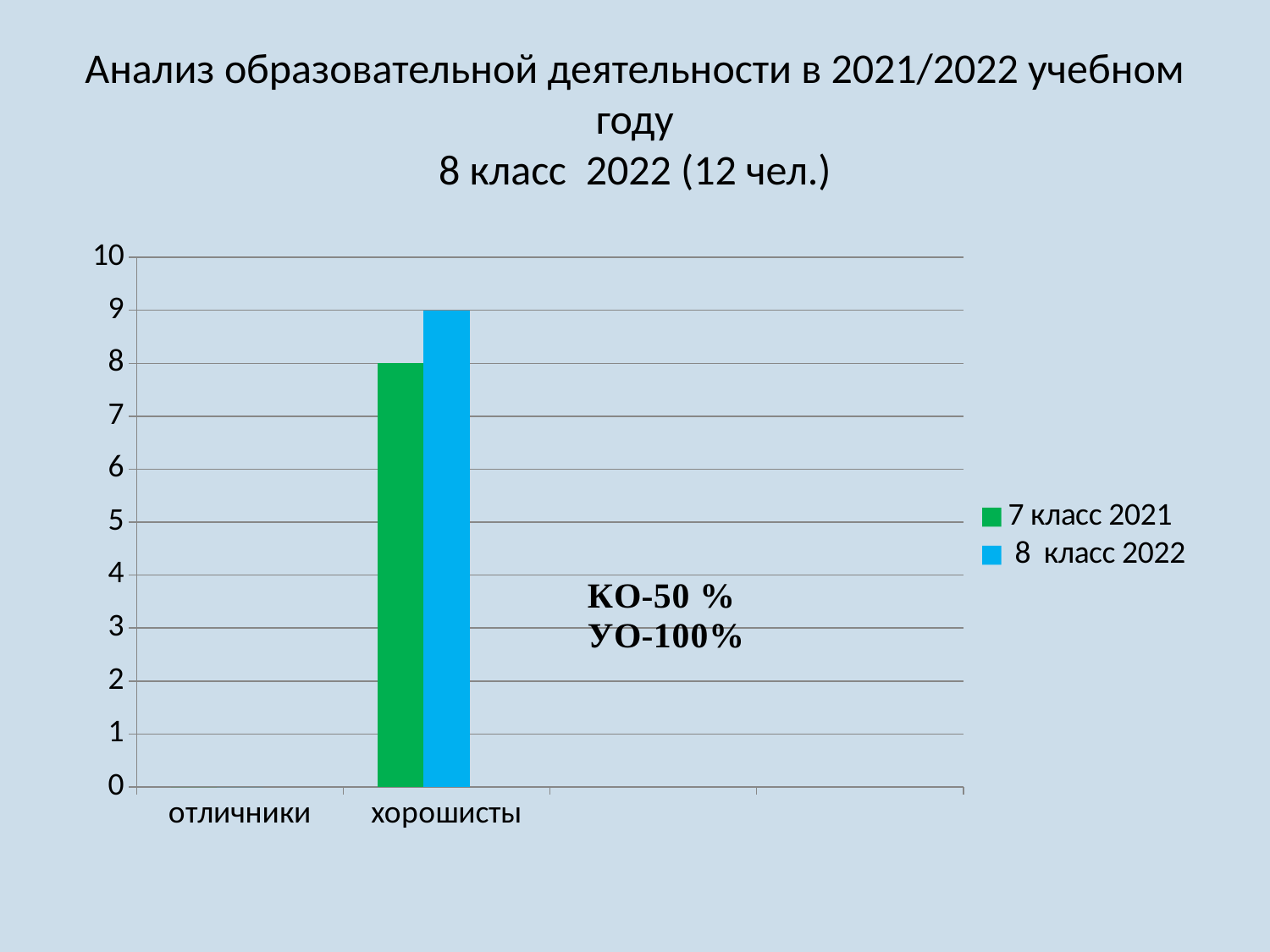
Which series has the larger value for хорошисты, 7 класс 2021 or 8 класс 2022? 8 класс 2022 What is the value for хорошисты in the 8 класс 2022 series? 9 How many series does the legend list? 2 What is the maximum value shown on the vertical axis? 10 What kind of chart is shown on the slide? bar chart Which category has the highest bars on the chart? хорошисты What colour represents the 8 класс 2022 series? blue What is the value for хорошисты in the 7 класс 2021 series? 8 Is the value for хорошисты in the 8 класс 2022 series greater or less than 10? less What is the value of УО shown in the text on the chart? 100% What is the difference between the 8 класс 2022 and 7 класс 2021 values for хорошисты? 1 Is the value for хорошисты in the 7 класс 2021 series greater or less than 5? greater